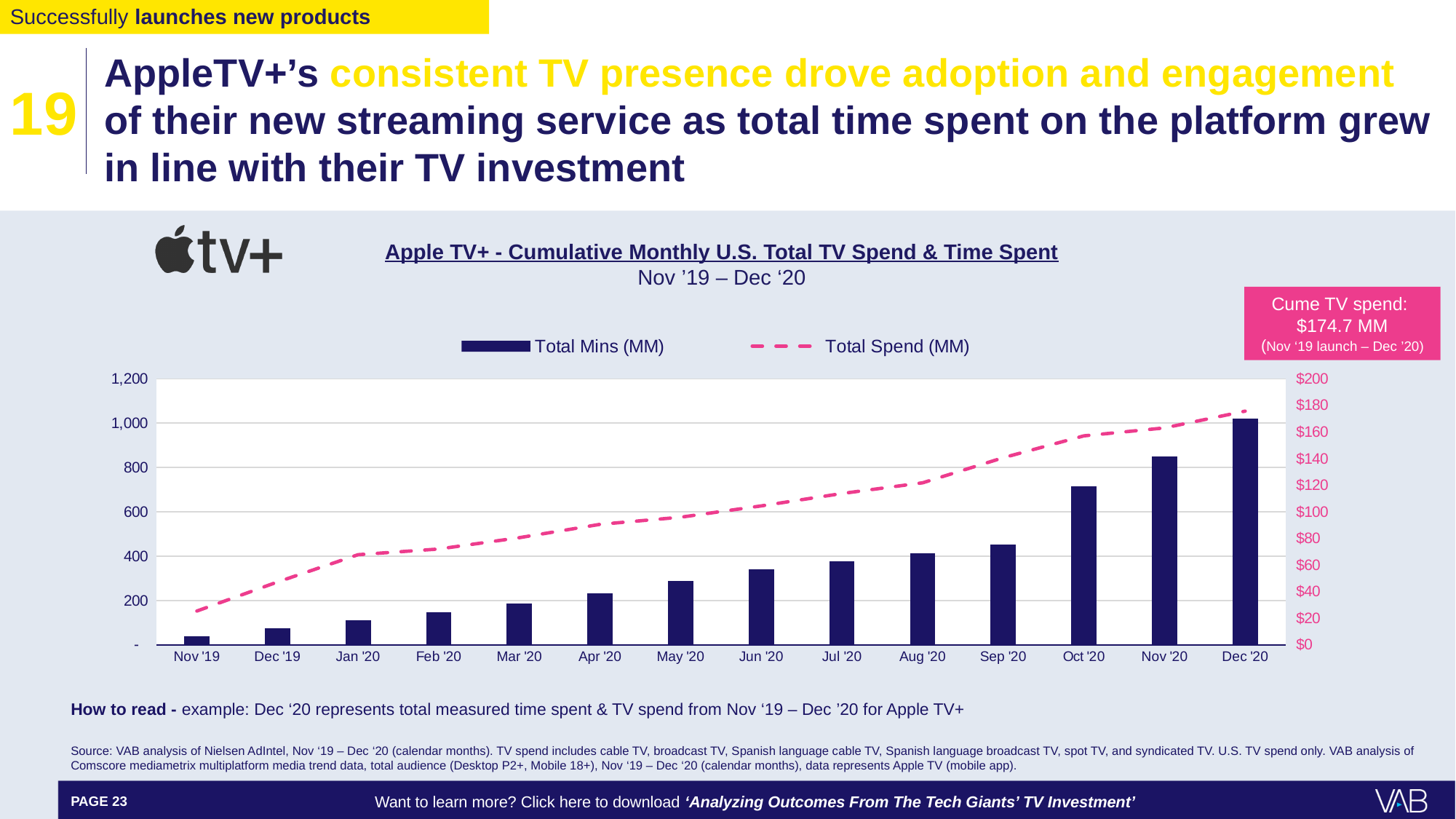
Which is larger, the Total Mins (MM) value for Nov '20 or for Jun '20? Nov '20 Which month has the lowest Total Mins (MM) bar? Nov '19 Which month has the highest Total Mins (MM) bar? Dec '20 Is the Total Mins (MM) value for Dec '20 greater or less than 800? greater Do the Total Mins (MM) values rise or fall from Nov '19 to Dec '20? rise How many series does the chart legend list? 2 Is the Total Mins (MM) value for Oct '20 greater or less than 600? greater Is the Total Spend (MM) value for Nov '19 greater or less than $40? less How many months are shown on the x axis of the chart? 14 What are the two series named in the chart legend? Total Mins (MM) and Total Spend (MM)